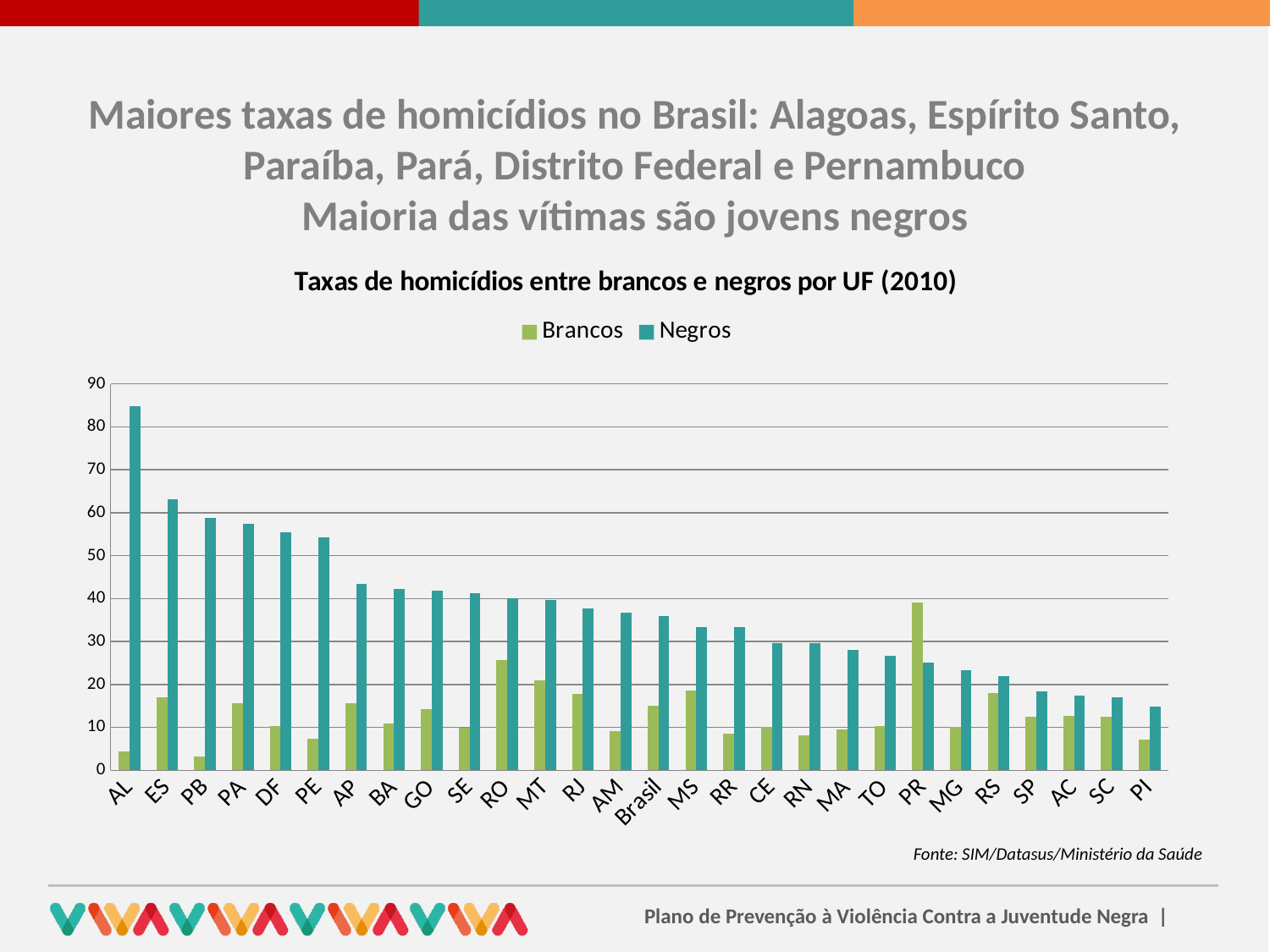
How many series does the legend list? 2 Do the Negros values generally rise or fall moving from left to right along the x axis? fall How many categories are shown along the x axis? 28 For PR, which series has the larger value, Brancos or Negros? Brancos Is the Brancos value for PR greater or less than 30? greater What is the title of the chart? Taxas de homicídios entre brancos e negros por UF (2010) Is the Negros value for PI greater or less than 20? less Which category has the highest value for the Brancos series? PR Is the Negros value for AL greater or less than 80? greater Which category has the highest value for the Negros series? AL What kind of chart is shown on the slide? bar chart